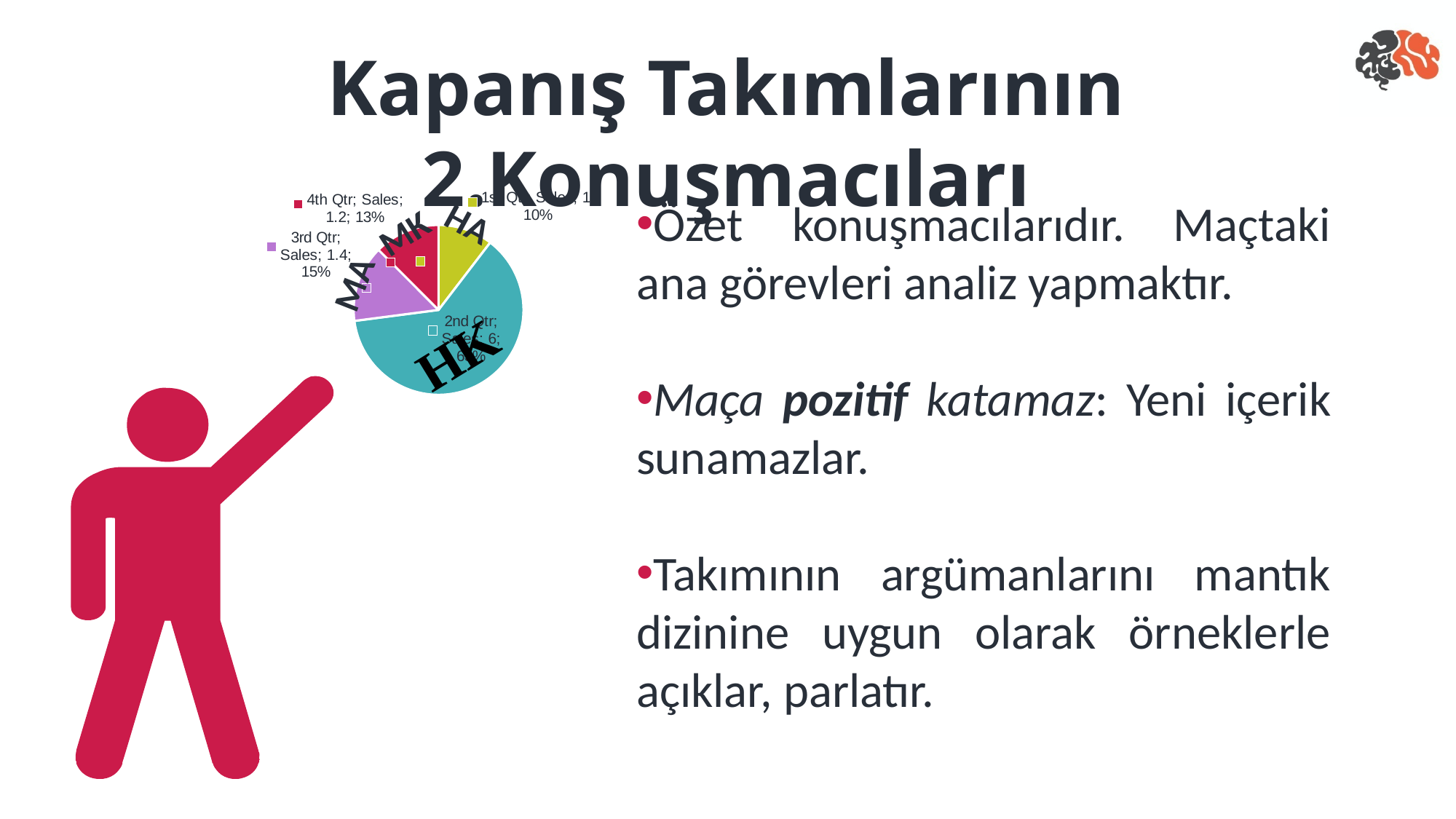
What is the difference between the Sales values for the 3rd Qtr and the 4th Qtr? 0.2 What kind of chart is shown on the slide? pie chart What percentage share does the 3rd Qtr slice have? 15% What is the Sales value for the 4th Qtr? 1.2 Which is larger, the 3rd Qtr slice or the 4th Qtr slice? 3rd Qtr What percentage share does the 1st Qtr slice have? 10% What is the name of the data series shown in the pie chart labels? Sales What is the Sales value for the 3rd Qtr? 1.4 What percentage share does the 4th Qtr slice have? 13% Which quarter has the smallest slice of the pie? 1st Qtr Which quarter has the largest slice of the pie? 2nd Qtr How many slices does the pie chart have? 4